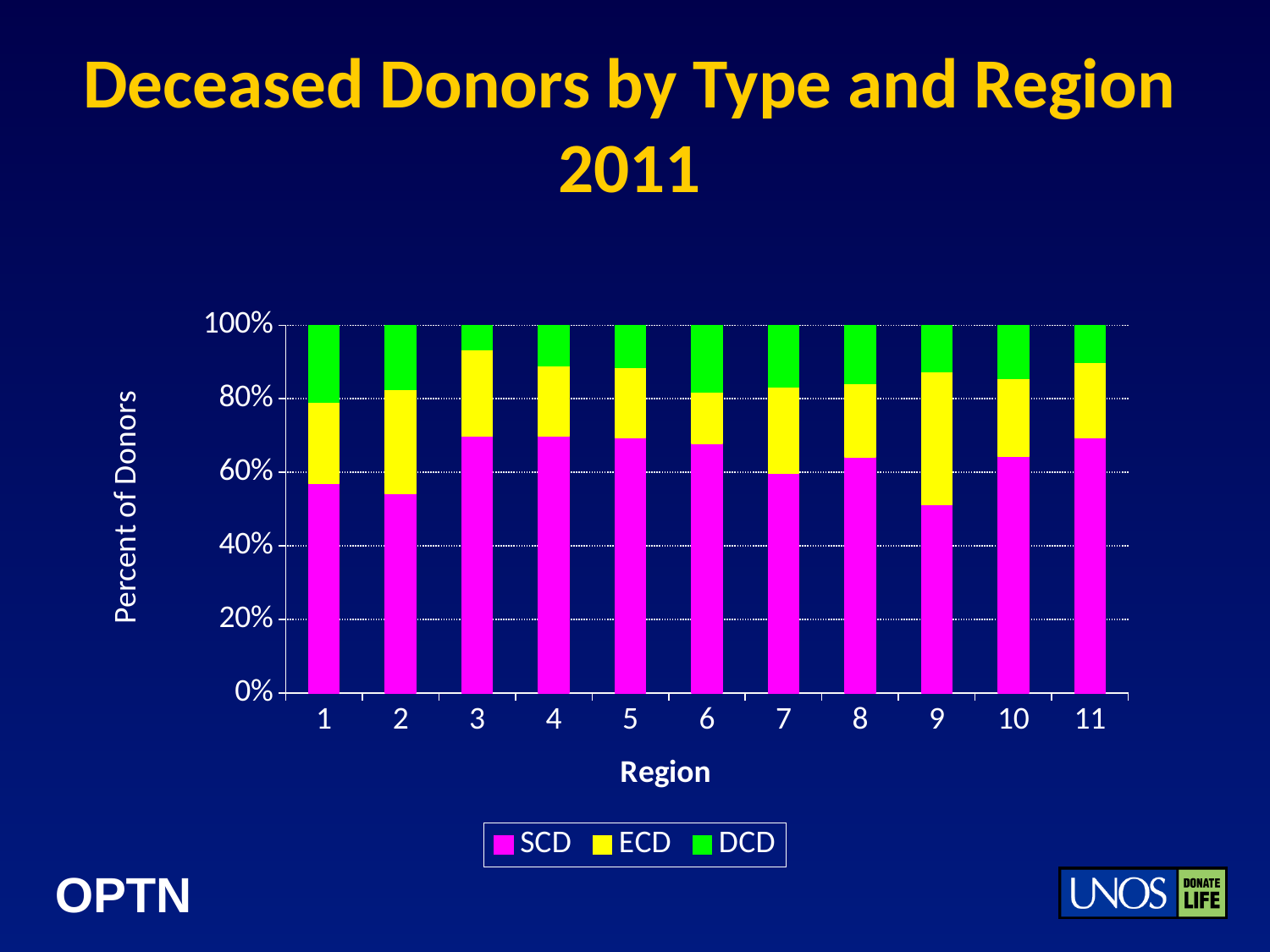
Is the SCD share for Region 2 greater or less than 60%? less Is the SCD share for Region 3 greater or less than 60%? greater What type of chart is shown on the slide? Stacked bar chart How many regions are shown along the x axis? 11 What does each stacked bar total? 100% Which region has the smallest DCD share? Region 3 Is the SCD share for Region 9 greater or less than 60%? less Which region has the largest ECD share? Region 9 How many series does the legend list? 3 Which has a larger SCD share, Region 3 or Region 9? Region 3 What is the title of the chart? Deceased Donors by Type and Region 2011 What are the three donor types listed in the legend? SCD, ECD, DCD